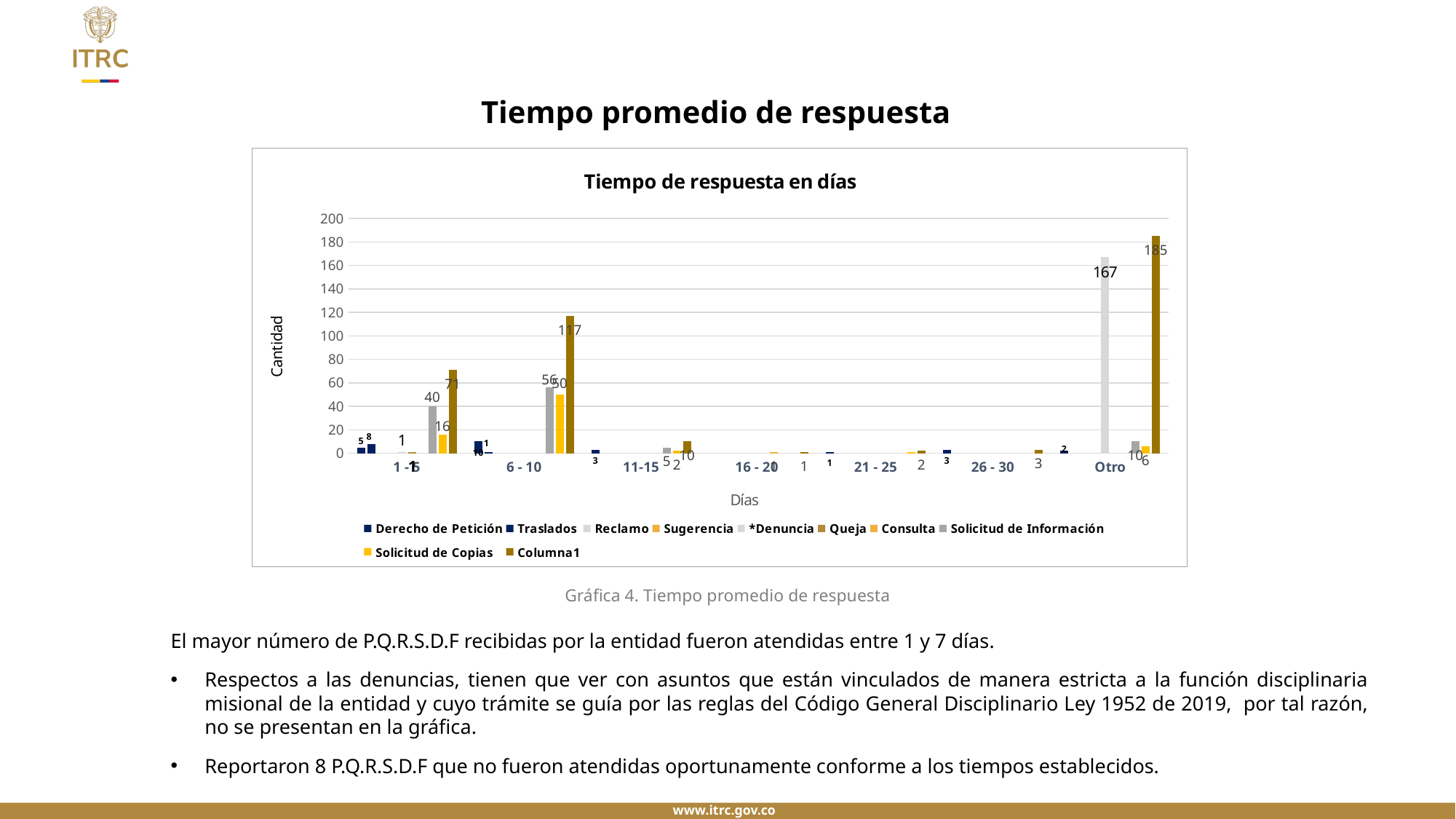
What is the value of the Columna1 bar in the 6 - 10 category? 117 What is the highest value labelled anywhere on the chart? 185 Which category has the taller Columna1 bar, 1 - 5 or 6 - 10? 6 - 10 How many series does the chart legend list? 10 Is the value of the tallest bar in the Otro category greater or less than 180? greater What kind of chart is shown on the slide? Bar chart In which x-axis category does the tallest bar of the chart appear? Otro How many categories are shown along the x axis of the chart? 7 What is the difference between the two tallest bars in the Otro category (185 and 167)? 18 What is the title of the vertical axis of the chart? Cantidad What is the value of the Columna1 bar in the 1 - 5 category? 71